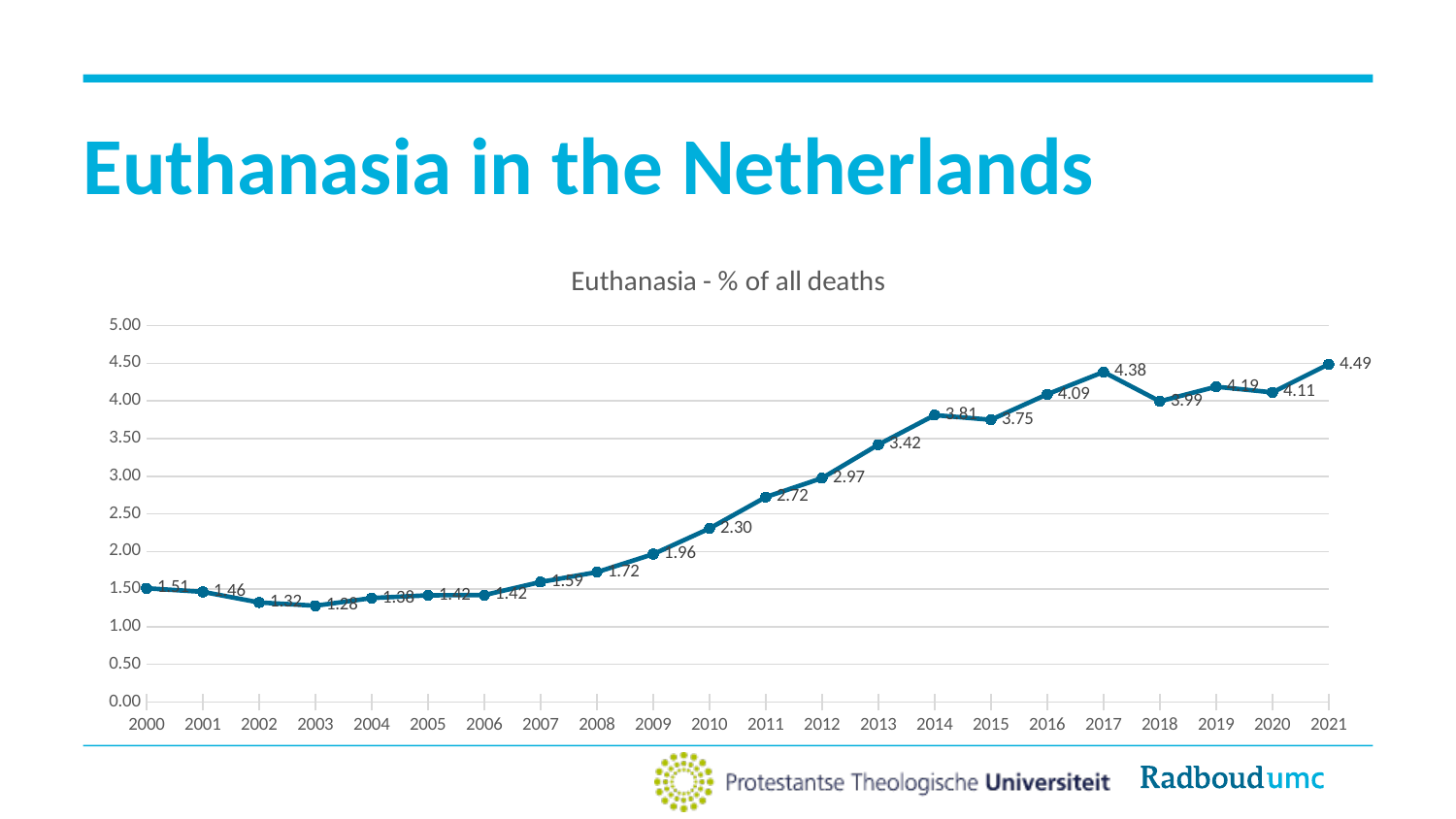
What is the value for 2000? 1.51 What is the value for 2017? 4.38 Which year has the lowest value? 2003 What is the title of the chart? Euthanasia - % of all deaths What type of chart is shown on the slide? line chart How many years are plotted on the x axis? 22 Do the values generally rise or fall from 2000 to 2021? rise Which is larger, the value for 2017 or the value for 2018? 2017 Which year has the highest value? 2021 What is the difference between the values for 2021 and 2000? 2.98 What is the value for 2010? 2.30 What is the value for 2021? 4.49